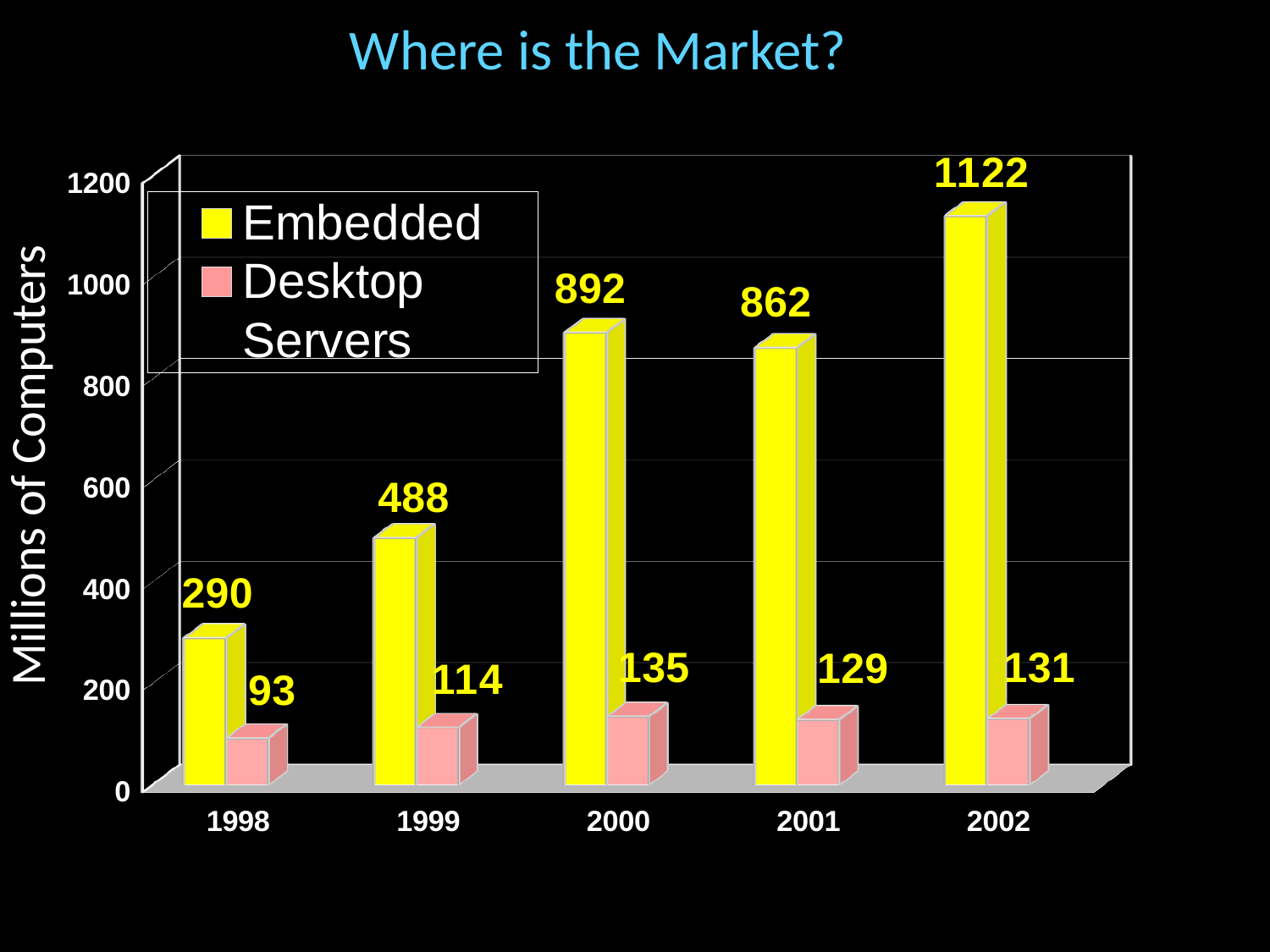
What is the Embedded value for 2002? 1122 What is the Embedded value for 1999? 488 What colour are the Embedded bars? Yellow Which is larger, the Embedded value for 2000 or the Embedded value for 2001? 2000 What is the y-axis label of the chart? Millions of Computers What kind of chart is shown on the slide? Bar chart How many years are shown on the x axis? 5 Which year has the highest Embedded value? 2002 How many series does the legend list? 3